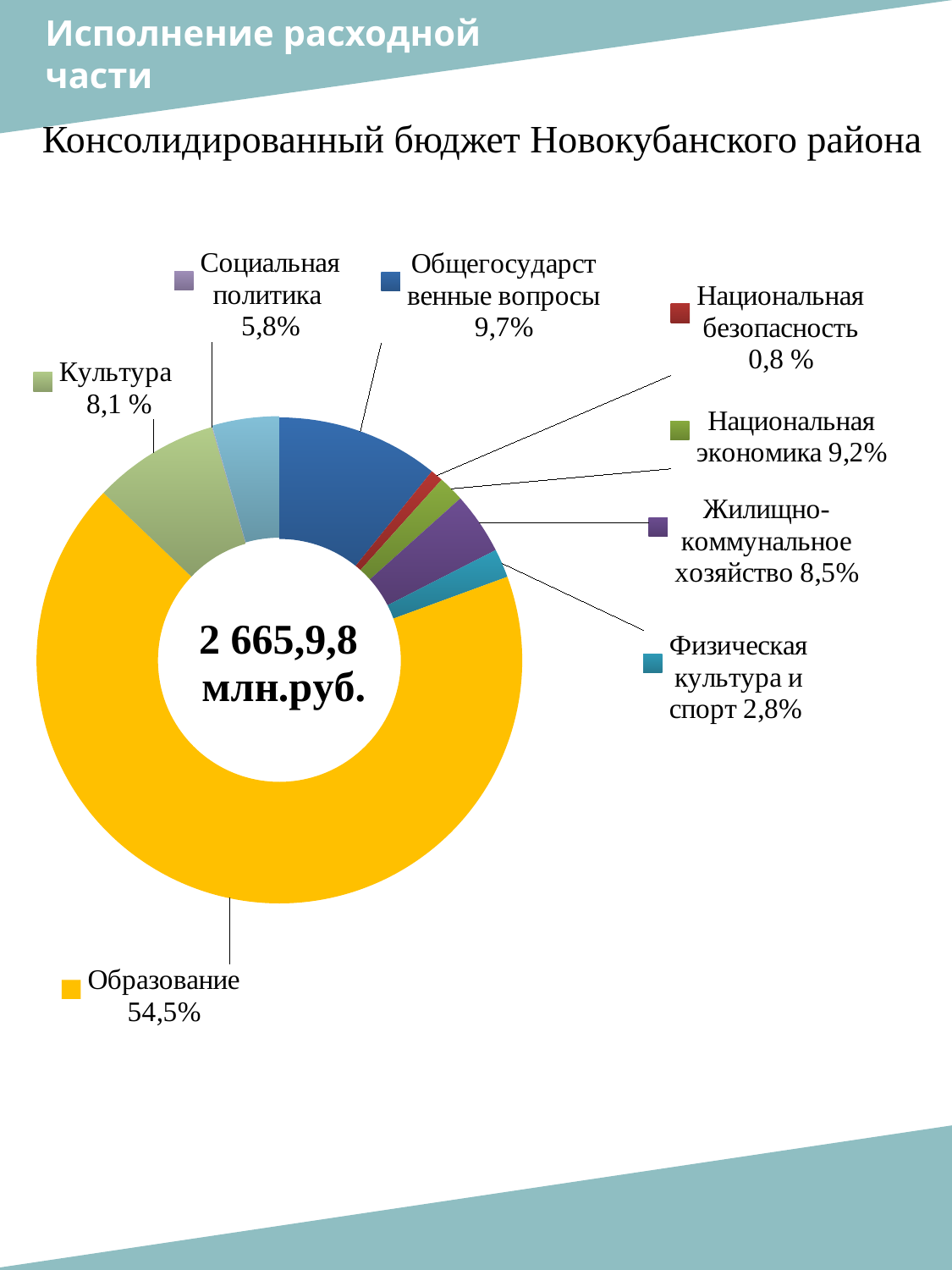
What total amount is printed in the centre of the chart? 2 665,9,8 млн.руб. What share is shown for Общегосударственные вопросы? 9,7% What share is shown for Физическая культура и спорт? 2,8% What share is shown for Национальная безопасность? 0,8 % How many categories are shown in the chart? 8 Which category has the largest share of the chart? Образование What kind of chart is shown on the slide? Pie (doughnut) chart Which category has the smallest share of the chart? Национальная безопасность Which has the larger share: Культура or Социальная политика? Культура What is the difference in percentage points between Общегосударственные вопросы and Национальная экономика? 0,5